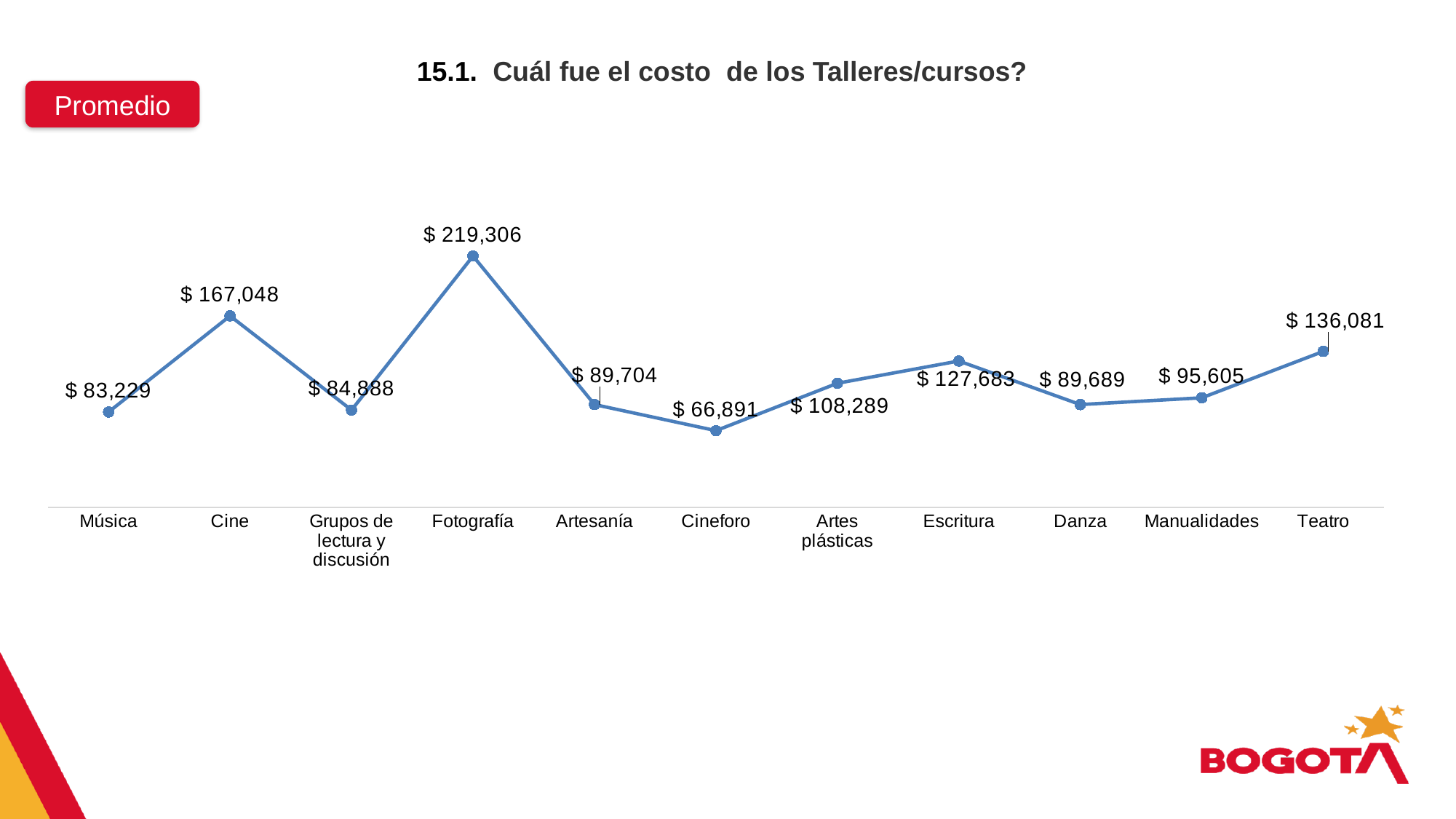
Which workshop/course category has the lowest average cost? Cineforo What is the average cost shown for Grupos de lectura y discusión? $ 84,888 How many workshop/course categories are plotted on the chart? 11 What is the average cost shown for Teatro? $ 136,081 What is the average cost shown for Cineforo? $ 66,891 What is the title of the chart? 15.1. Cuál fue el costo de los Talleres/cursos? What is the difference between the average cost for Teatro and for Música? $ 52,852 Which workshop/course category has the highest average cost? Fotografía What is the average cost shown for Fotografía? $ 219,306 What kind of chart is shown on the slide? Line chart Which has a higher average cost, Cine or Teatro? Cine What is the difference between the average cost for Fotografía and for Cine? $ 52,258